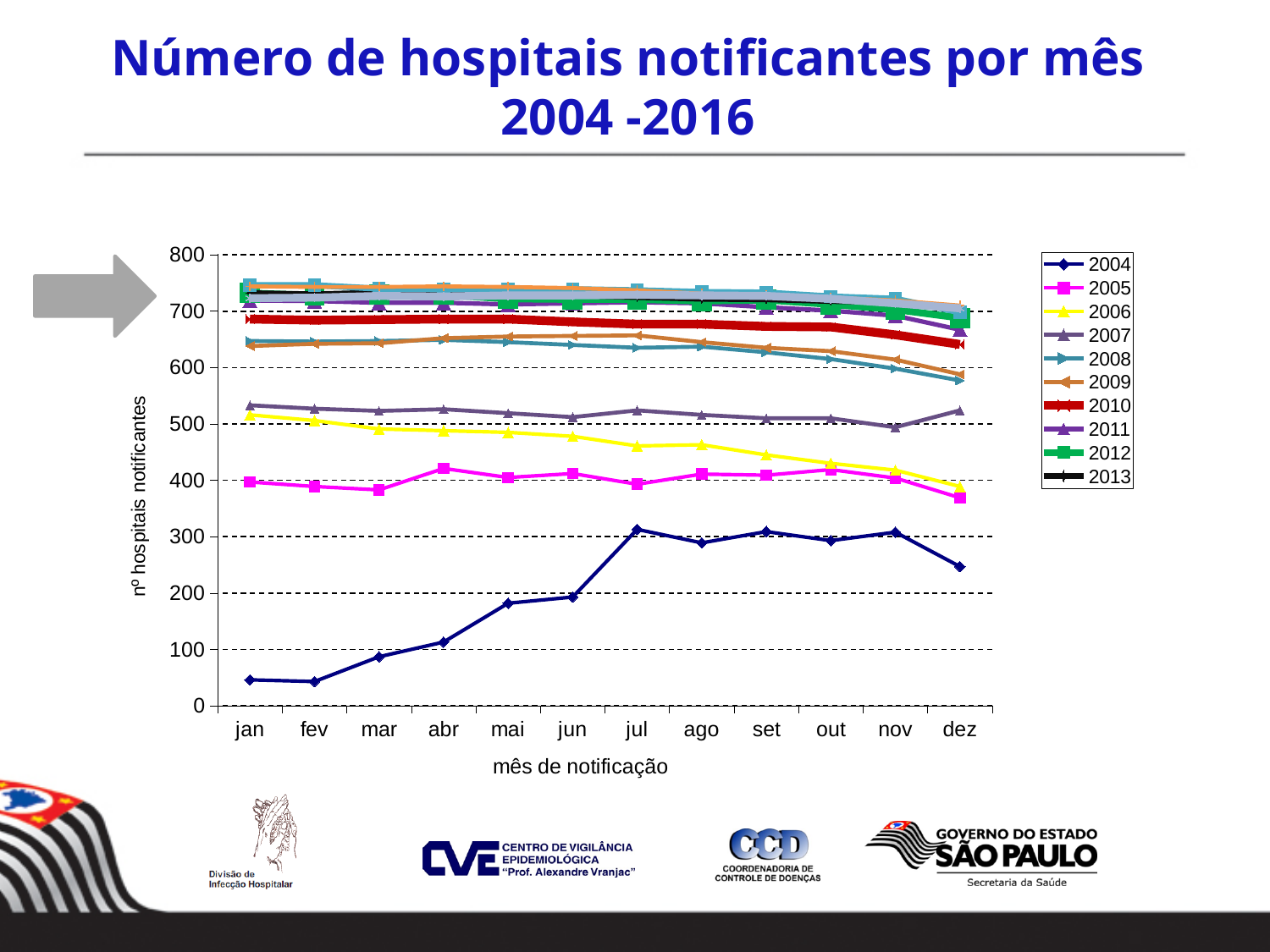
Is the value for 2004 in dez greater or less than 300? less Is the value for 2004 in jan greater or less than 100? less How many months are shown along the x axis? 12 What kind of chart is shown on the slide? line chart Which series has the lowest values across the whole chart? 2004 Does the 2006 series rise or fall from jan to dez? fall Does the 2004 series rise or fall from jan to dez? rise In jun, which series has the larger value, 2006 or 2007? 2007 How many series does the legend list? 10 Is the value for 2005 in dez greater or less than 400? less What is the label of the y axis? nº hospitais notificantes